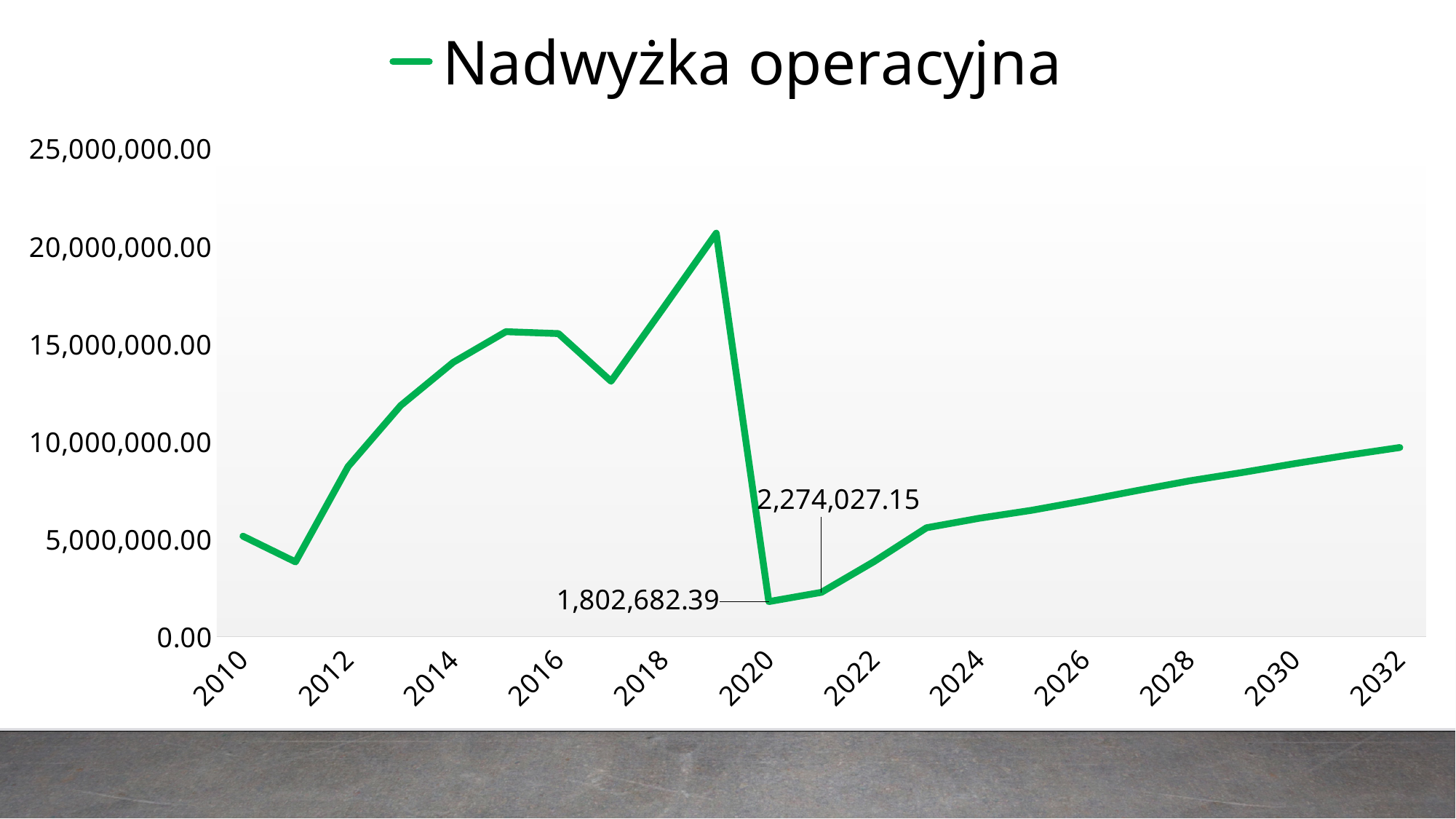
Is the value for 2011 greater or less than 5,000,000.00? less In which year is Nadwyżka operacyjna highest? 2019 Which year has the larger value, 2020 or 2021? 2021 In which year is Nadwyżka operacyjna lowest? 2020 Is the value for 2019 greater or less than 20,000,000.00? greater What is the value of Nadwyżka operacyjna for 2021? 2,274,027.15 What kind of chart is shown on the slide? line chart Do the values rise or fall from 2021 to 2032? rise What is the difference between the values for 2021 and 2020? 471,344.76 What is the value of Nadwyżka operacyjna for 2020? 1,802,682.39 How many series does the legend list? 1 Is the value for 2015 greater or less than 15,000,000.00? greater